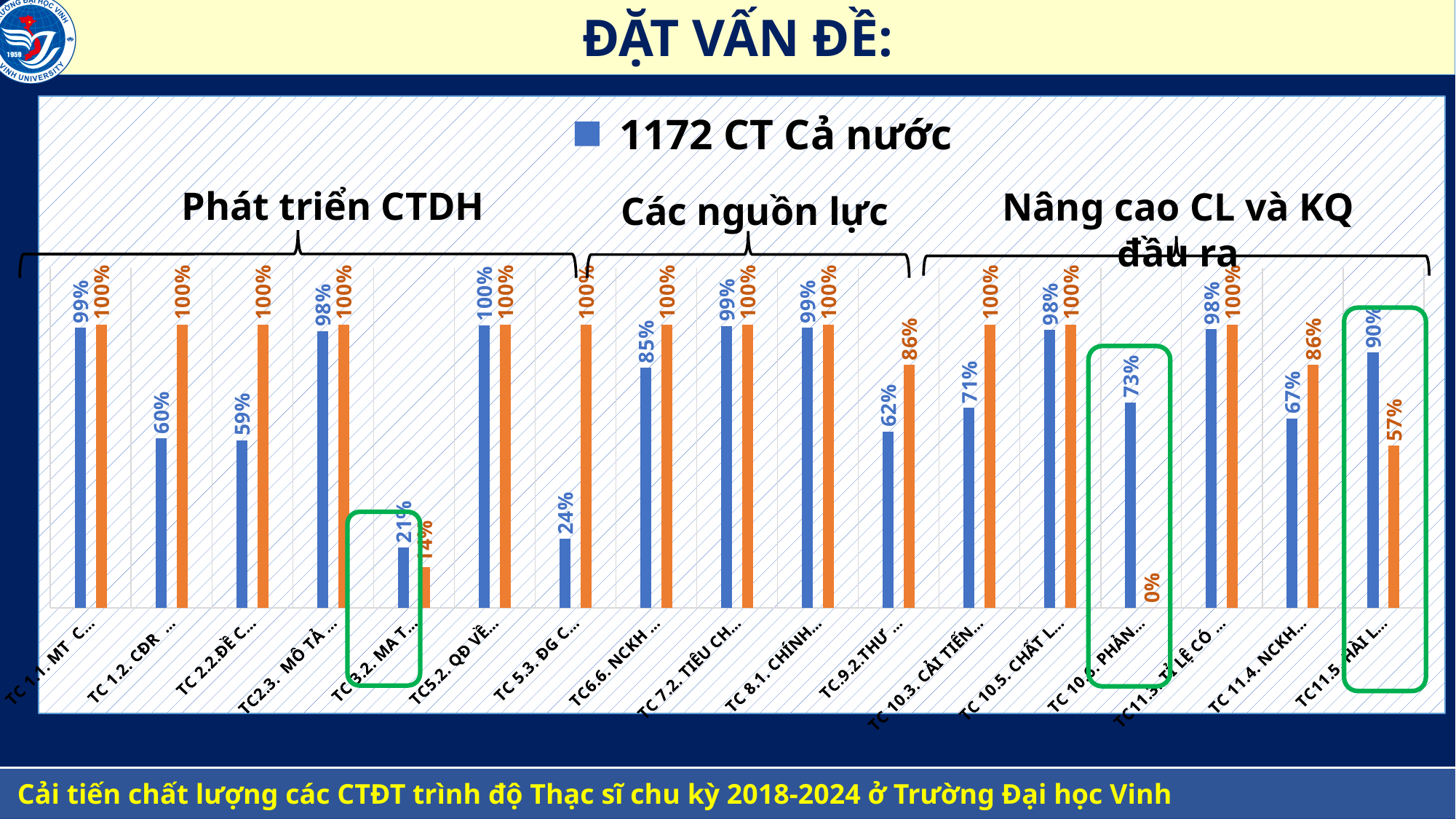
What is the legend entry shown above the chart? 1172 CT Cả nước What is the value of the blue bar for the category TC11.5? 90% What is the value of the orange bar for the category TC.9.2? 86% What is the value of the orange bar for the category TC11.5? 57% How many categories are shown on the x axis of the chart? 17 Which category has the lowest blue bar? TC 3.2 For the category TC 3.2, what is the difference between the blue bar (21%) and the orange bar (14%)? 7% What is the value of the blue bar for the category TC 10.6? 73% What is the value of the orange bar for the category TC 10.6? 0% What is the value of the blue bar for the category TC 5.3? 24% For the category TC 1.2, which bar is larger, the blue one or the orange one? The orange bar (100%) What kind of chart is shown on the slide? Bar chart